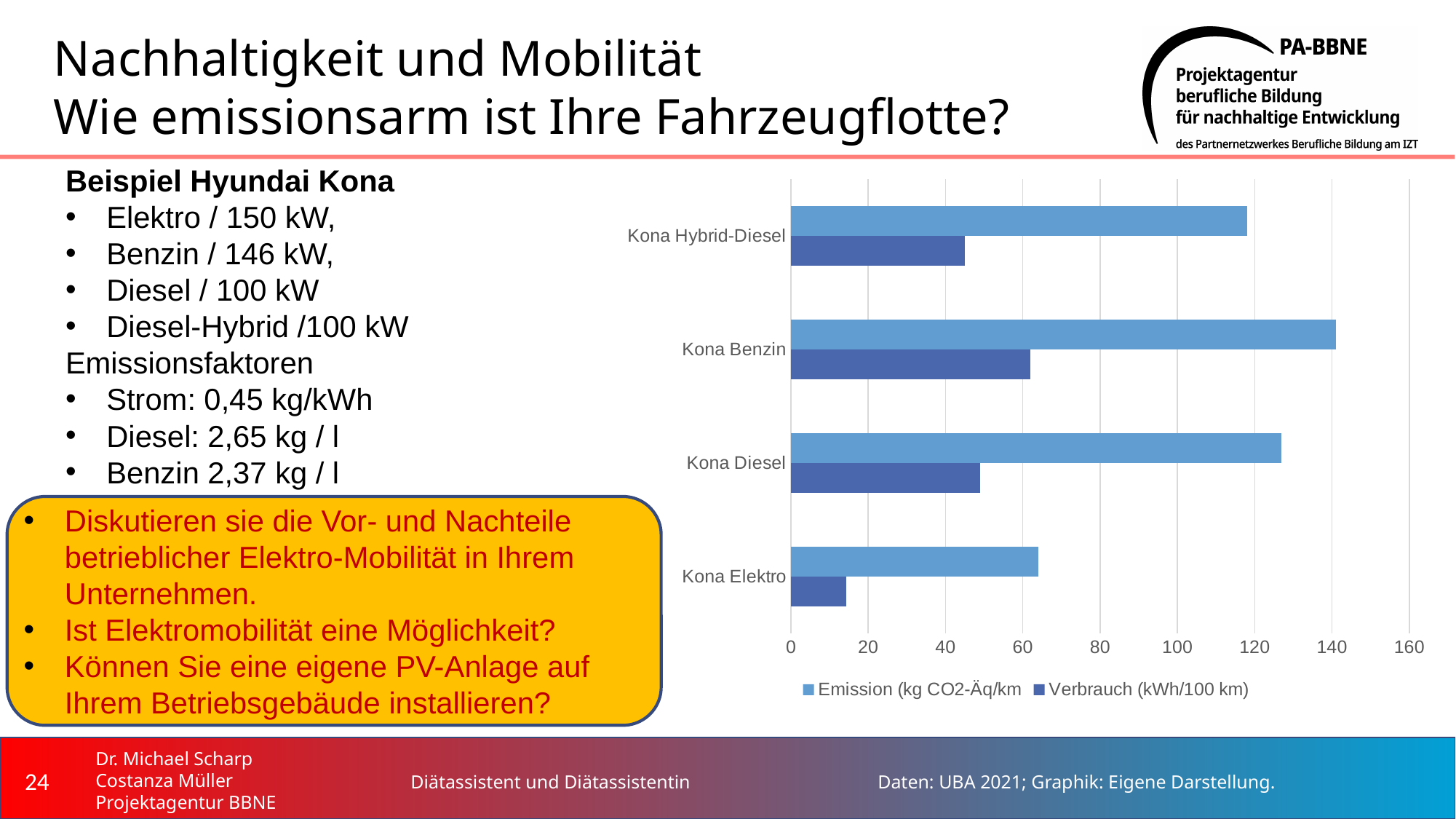
How many series does the chart legend list? 2 Which vehicle has the highest Verbrauch (kWh/100 km) value? Kona Benzin Which vehicle has the lowest Emission (kg CO2-Äq/km) value? Kona Elektro Which vehicle has the highest Emission (kg CO2-Äq/km) value? Kona Benzin How many vehicle categories are shown on the chart? 4 Is the Verbrauch value for Kona Elektro greater or less than 20? less Is the Emission value for Kona Elektro greater or less than 80? less Which vehicle has the lowest Verbrauch (kWh/100 km) value? Kona Elektro What kind of chart is shown on the slide? bar chart What are the two series named in the chart legend? Emission (kg CO2-Äq/km) and Verbrauch (kWh/100 km) Which is larger, the Emission value for Kona Diesel or for Kona Hybrid-Diesel? Kona Diesel